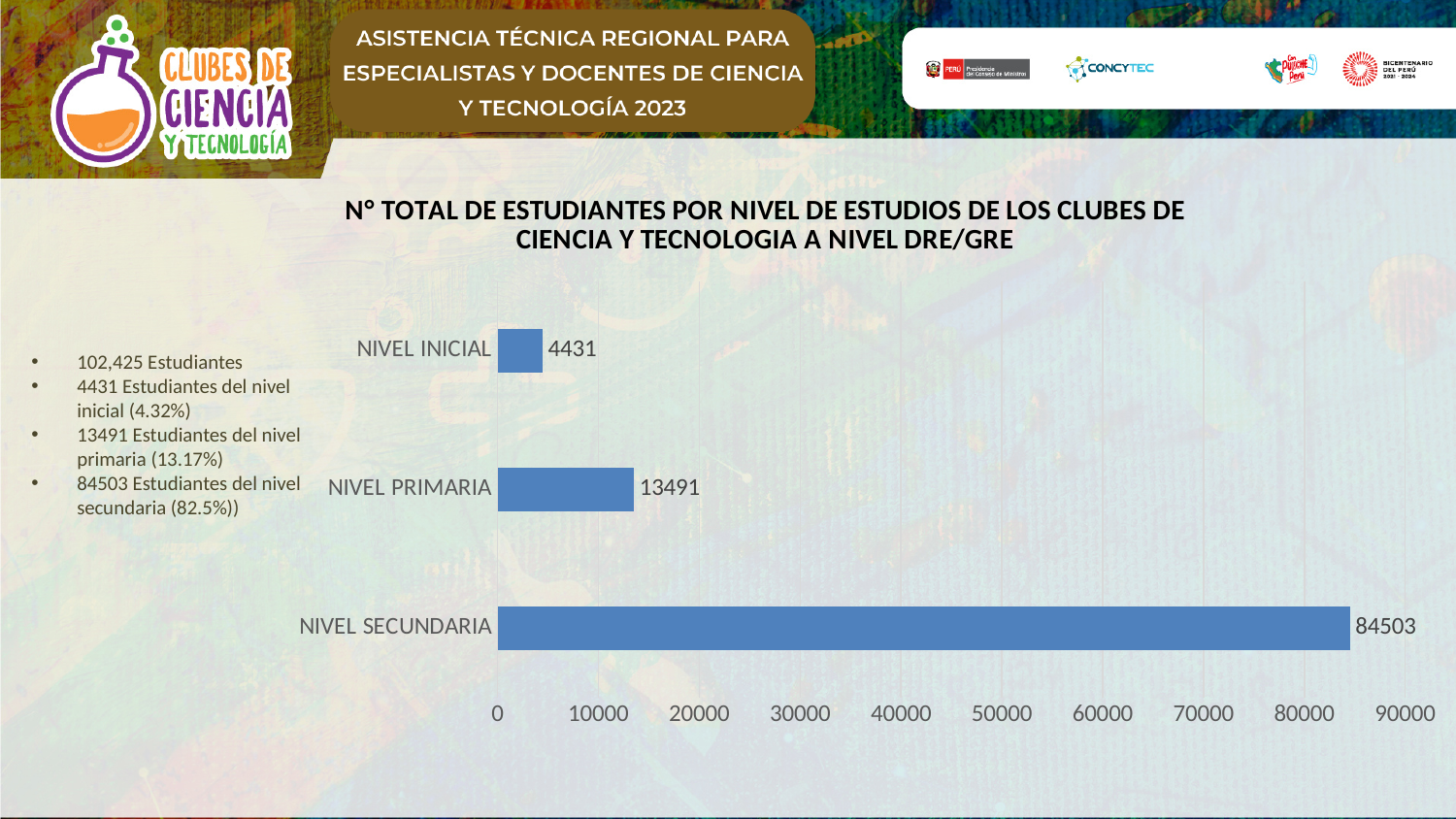
What is the difference between the values for NIVEL PRIMARIA and NIVEL INICIAL? 9060 Which level has the highest number of students? NIVEL SECUNDARIA What is the value for NIVEL SECUNDARIA? 84503 What is the value for NIVEL PRIMARIA? 13491 Which level has the lowest number of students? NIVEL INICIAL What is the difference between the values for NIVEL SECUNDARIA and NIVEL PRIMARIA? 71012 What is the highest value shown on the x axis? 90000 Is the value for NIVEL SECUNDARIA greater or less than 80000? greater What is the value for NIVEL INICIAL? 4431 How many categories are shown in the chart? 3 What kind of chart is shown on the slide? bar chart Which is larger, the value for NIVEL PRIMARIA or NIVEL INICIAL? NIVEL PRIMARIA